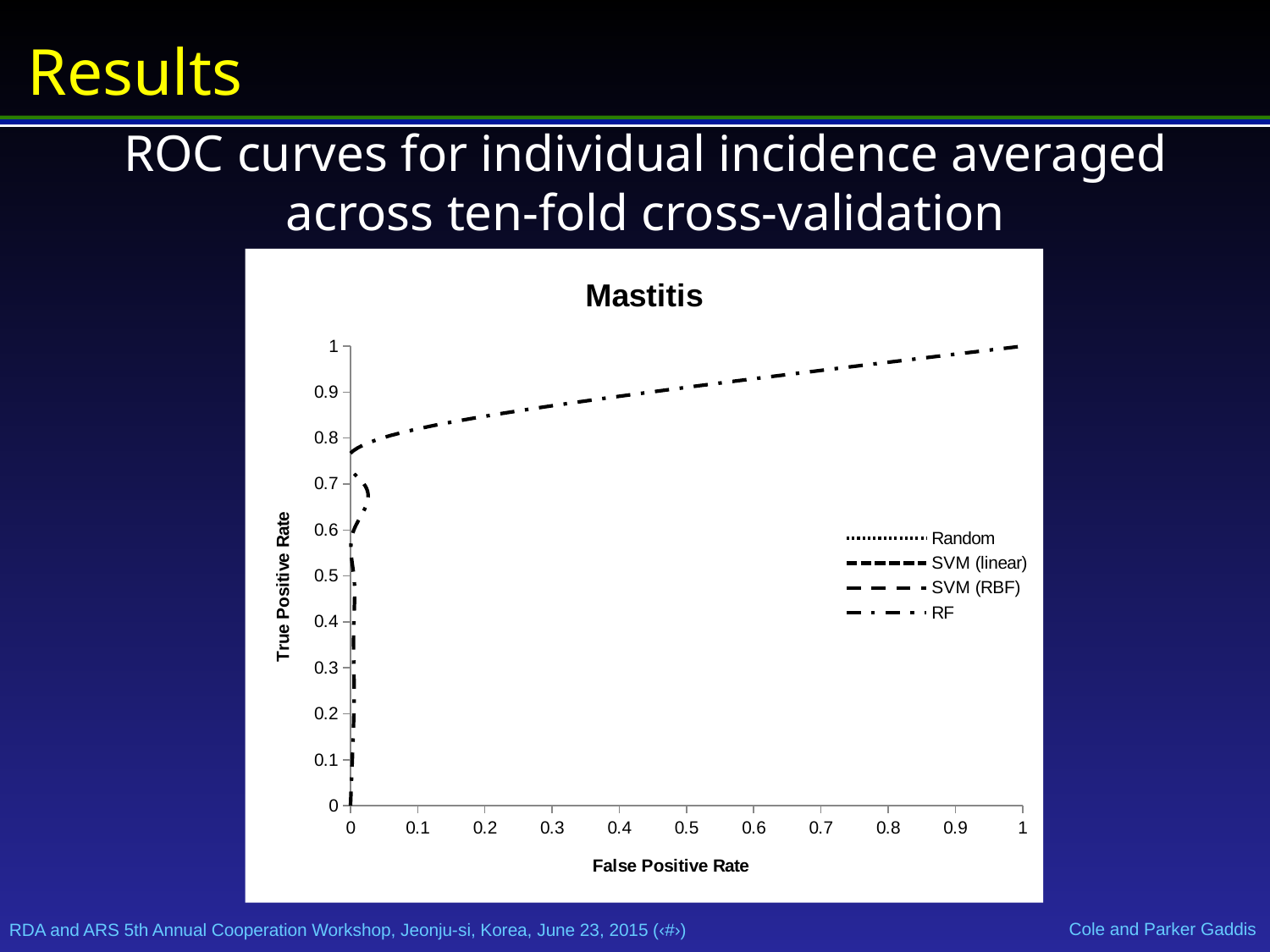
Does the RF curve rise or fall as the False Positive Rate increases from 0 to 1? rise Is the True Positive Rate of the RF curve at a False Positive Rate of 0.9 greater or less than 0.9? greater What kind of chart is shown on the slide? line chart What is the lowest value labelled on the False Positive Rate axis? 0 How many tick marks are labelled on the False Positive Rate axis? 11 Is the True Positive Rate of the RF curve at a False Positive Rate of 0.5 greater or less than 0.8? greater What is the title of the chart? Mastitis How many series does the chart's legend list? 4 Which series in the legend is drawn with a dash-dot line? RF What is the highest value labelled on the True Positive Rate axis? 1 What True Positive Rate does the RF curve reach at a False Positive Rate of 1? 1 What label is on the vertical axis of the chart? True Positive Rate